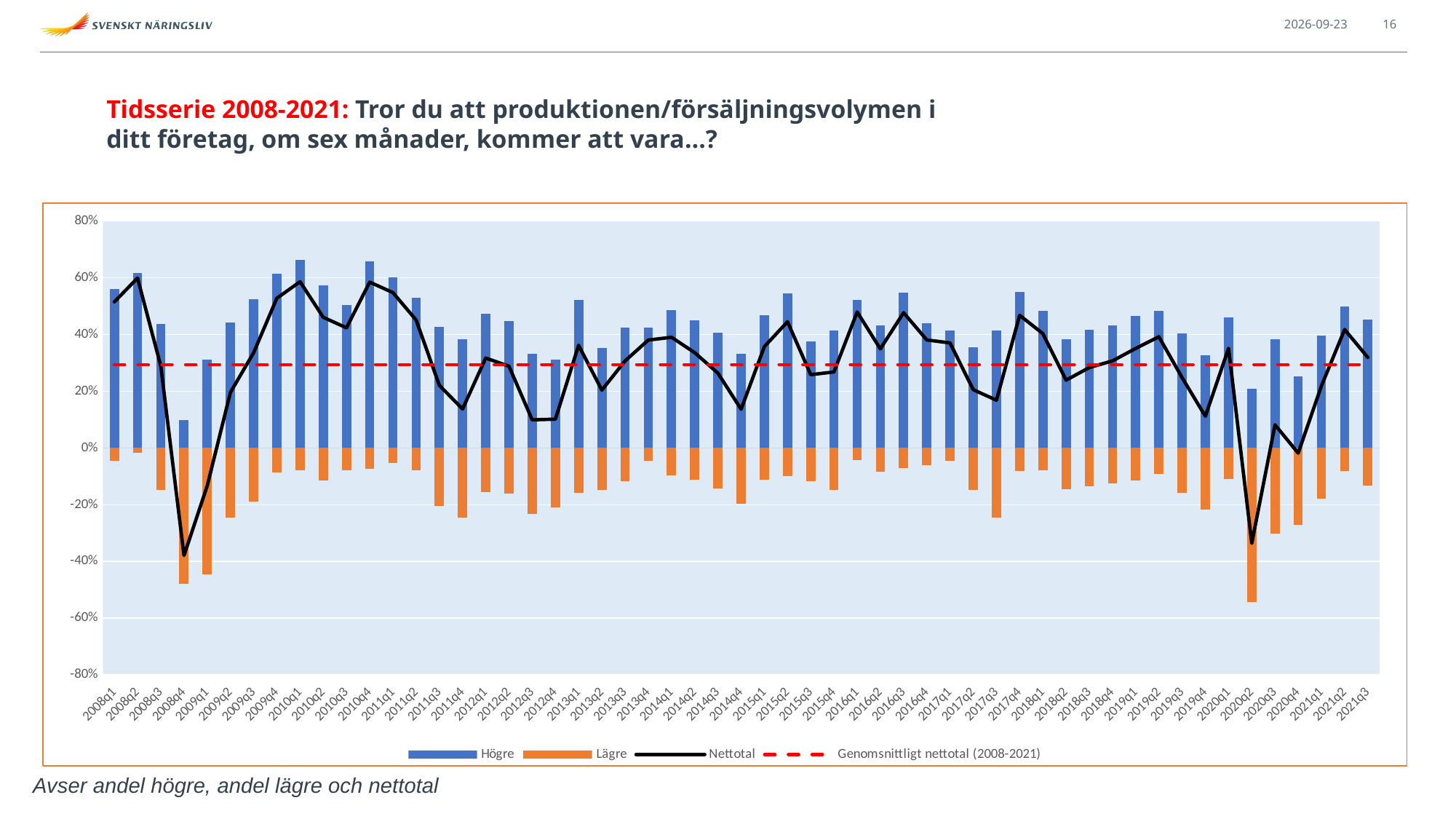
Which quarter has the lowest Högre value? 2008q4 Is the Högre value for 2010q1 greater or less than 60%? greater Is the Högre value for 2008q4 greater or less than 20%? less Is the Nettotal value for 2008q4 greater or less than -20%? less What does the red dashed line in the chart represent? Genomsnittligt nettotal (2008-2021) How many quarters are shown on the x axis? 55 Which has the larger Högre value, 2008q4 or 2009q1? 2009q1 Which quarter has the most negative Lägre value? 2020q2 What kind of chart is shown on the slide? Bar chart with line series Does the Nettotal line rise or fall from 2020q2 to 2021q2? rise How many series does the legend list? 4